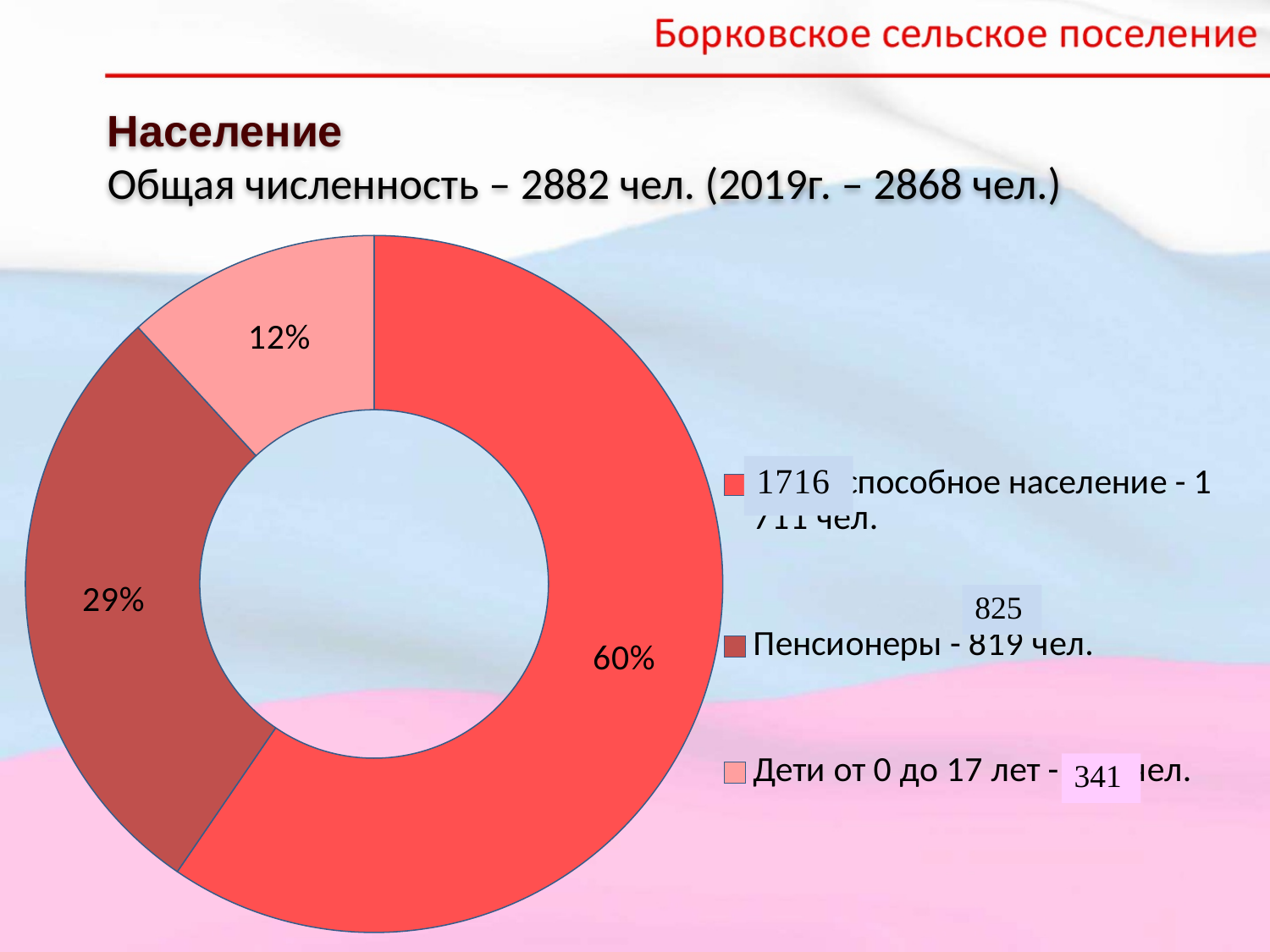
Which has the larger share, Пенсионеры or Дети от 0 до 17 лет? Пенсионеры What kind of chart is shown on the slide? doughnut (pie) chart What is the difference in percentage points between the 60% slice and the 29% slice? 31 percentage points What colour is the slice for Дети от 0 до 17 лет? light pink How many slices does the doughnut chart have? 3 What share of the chart is labelled for Дети от 0 до 17 лет? 12% What percentage share is shown for the largest slice of the chart? 60% Is the largest slice of the chart greater or less than 50%? greater By how many percentage points does the Пенсионеры share exceed the Дети от 0 до 17 лет share? 17 percentage points Which category has the smallest share in the chart? Дети от 0 до 17 лет What share of the chart is labelled for Пенсионеры? 29% How many entries does the chart legend list? 3